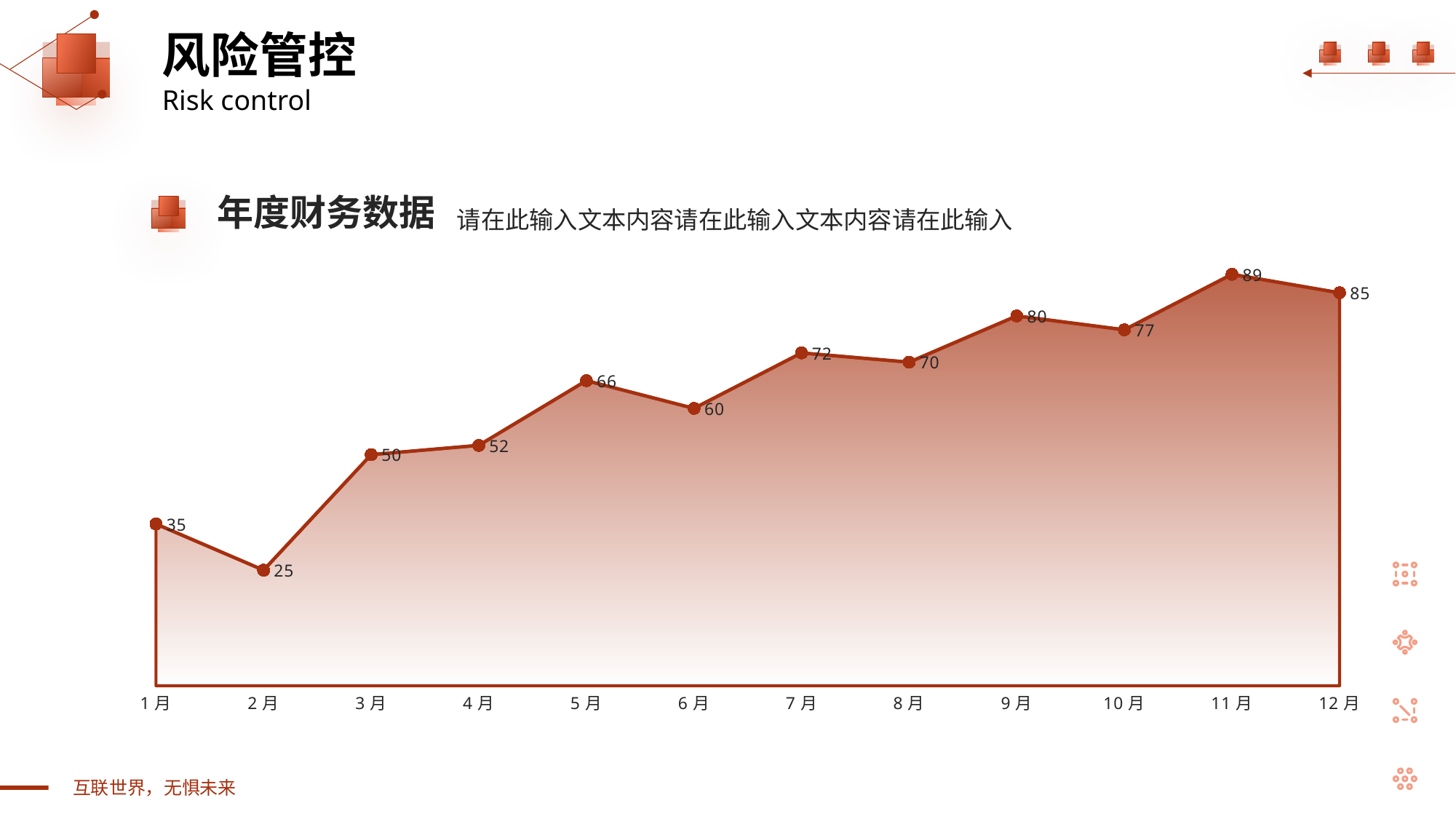
What is the difference between the values for 9月 and 8月? 10 Which month has the lowest value? 2月 What is the difference between the values for 11月 and 1月? 54 What is the title of the section containing the chart? 年度财务数据 Which is larger, the value for 5月 or the value for 6月? 5月 Do the values generally rise or fall from 1月 to 12月? rise What kind of chart is shown on the slide? area chart What is the value for 12月? 85 What is the value for 7月? 72 How many months are plotted on the chart? 12 Which month has the highest value? 11月 What is the value for 3月? 50